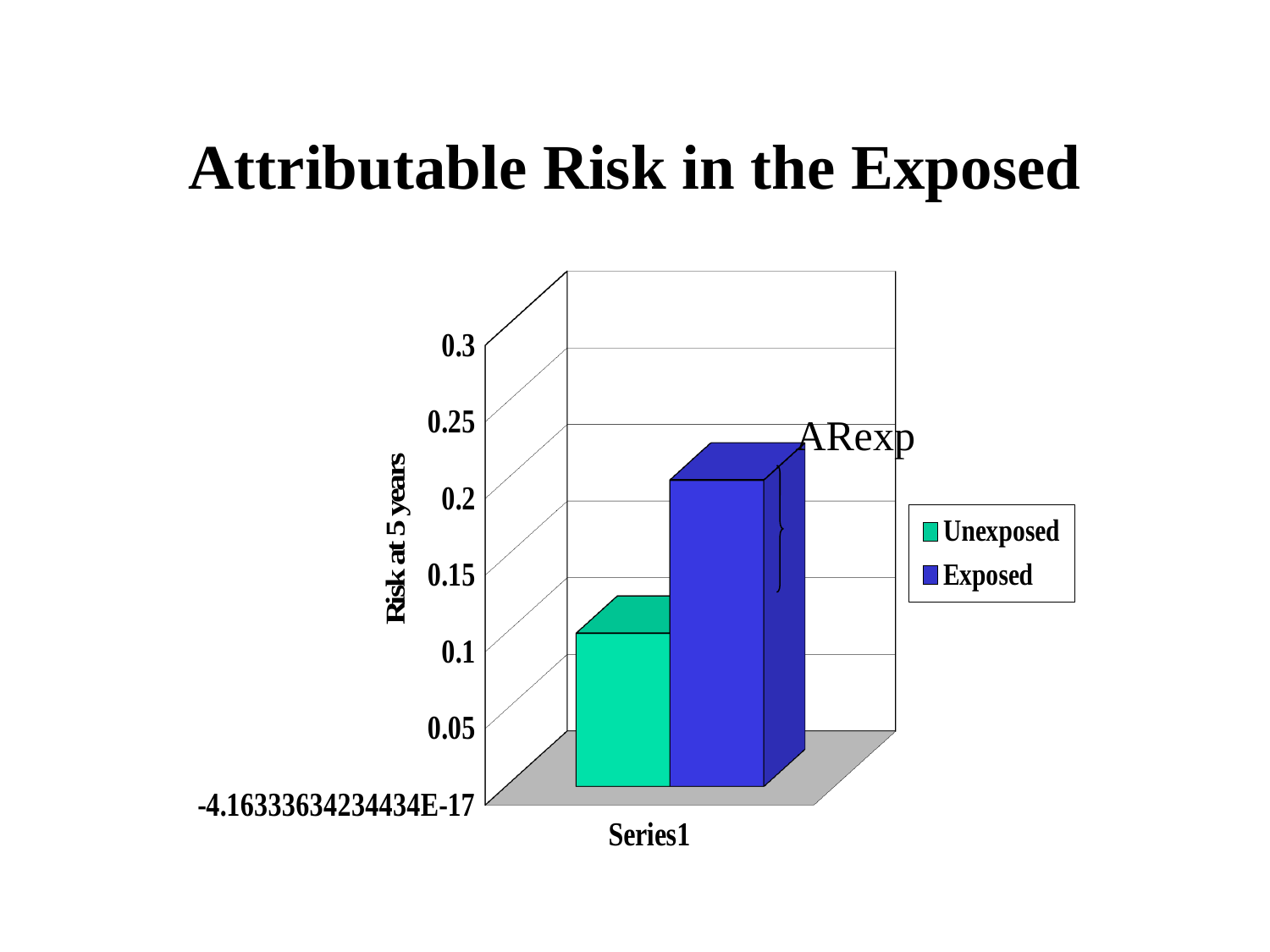
Is the value for Unexposed greater or less than 0.15? less Which series has the lowest risk at 5 years? Unexposed Is the value for Exposed greater or less than 0.25? less Which series has the highest risk at 5 years? Exposed What is the title of the chart? Attributable Risk in the Exposed Is the value for Unexposed greater or less than 0.05? greater How many categories are shown on the x axis? 1 What is the label of the vertical axis? Risk at 5 years What kind of chart is shown on the slide? bar chart Which series has the taller bar, Unexposed or Exposed? Exposed How many series does the legend list? 2